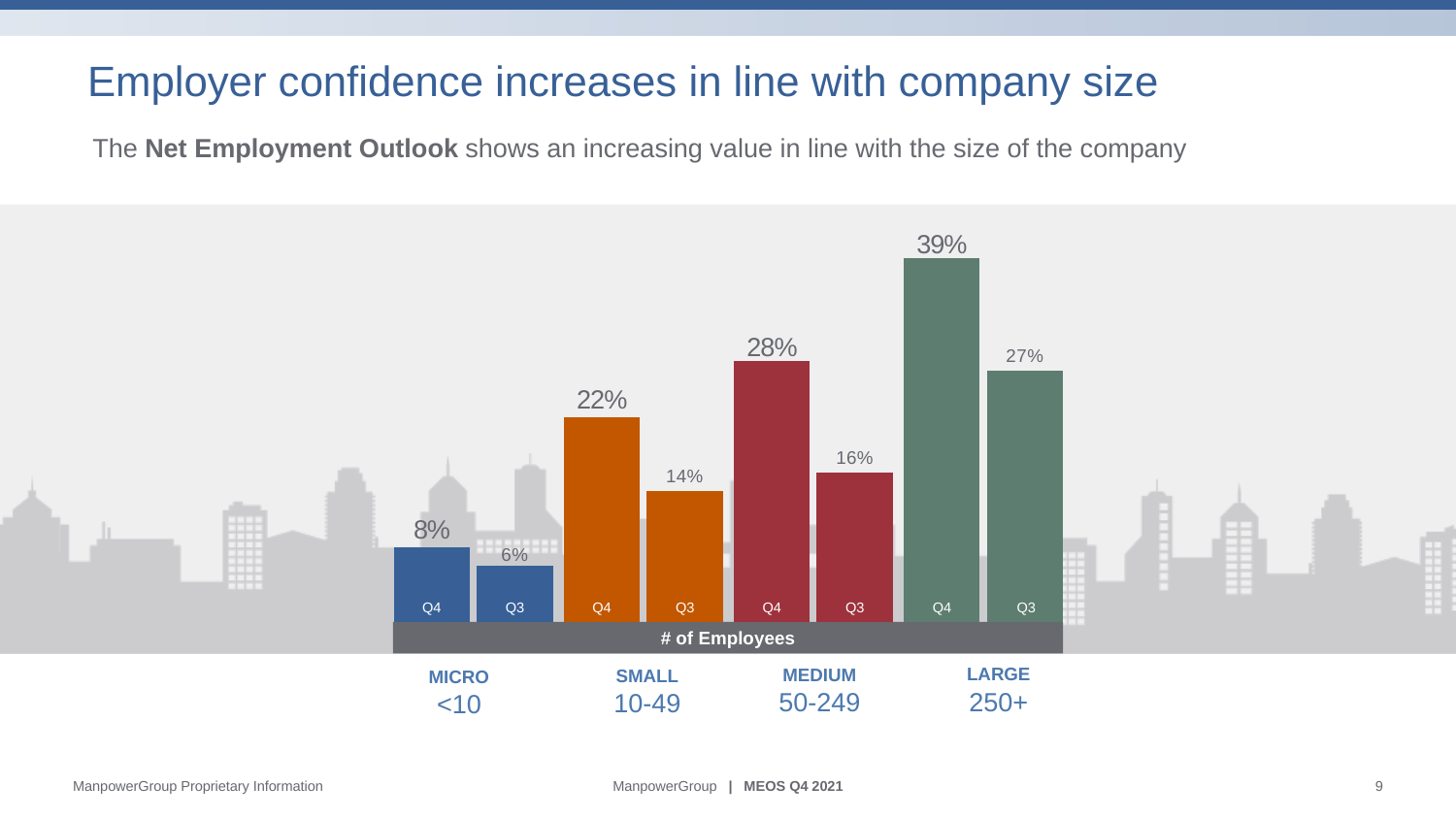
Do the Q4 values rise or fall as company size increases from Micro to Large? Rise Which is larger: the Q4 value for Small companies or the Q3 value for Medium companies? Q4 value for Small companies (22%) Which company size category has the lowest Q3 value? Micro (<10) How many company size categories are shown in the chart? 4 What is the Q4 value for Medium companies (50-249 employees)? 28% What is the Q3 value for Small companies (10-49 employees)? 14% What is the difference between the Q4 and Q3 values for Large companies? 12 percentage points Which company size category has the highest Q4 value? Large (250+) What is the Q3 value for Large companies (250+ employees)? 27% What is the Q4 Net Employment Outlook for Micro companies (<10 employees)? 8% What is the difference between the Q4 values for Medium and Small companies? 6 percentage points What type of chart is shown on the slide? Bar chart